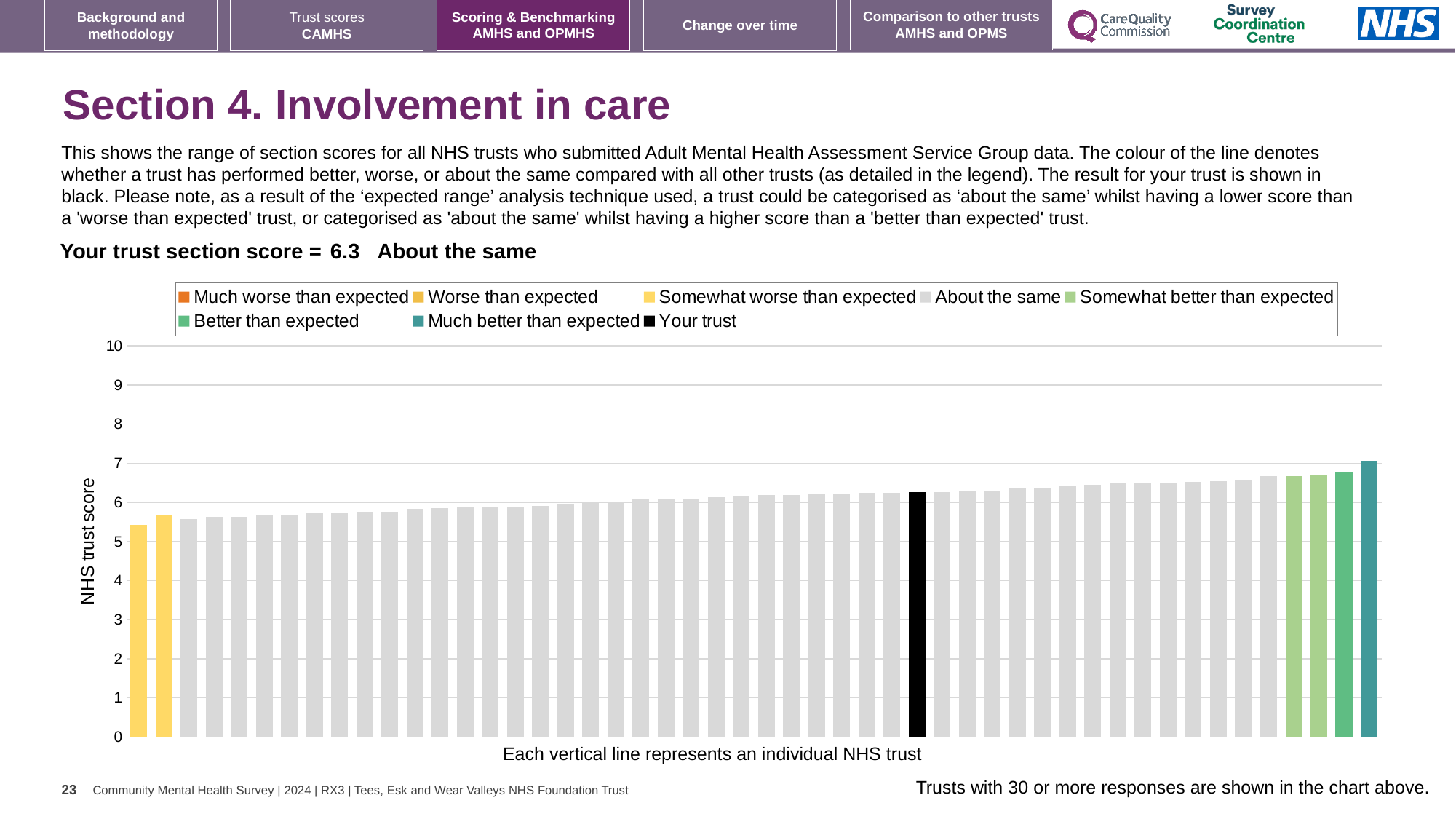
What is your trust's section score for Involvement in care? 6.3 What is the label on the y axis of the chart? NHS trust score Is the rightmost bar higher or lower than your trust's black bar? higher How many entries does the chart legend list? 8 Is the value for your trust (the black bar) greater or less than 6? greater How many bars are coloured as 'Somewhat worse than expected'? 2 Do the bar values rise or fall from left to right along the x axis? rise Which legend category does the lowest bar belong to? Somewhat worse than expected Is the value of the leftmost bar greater or less than 5? greater What kind of chart is shown on the slide? bar chart Is the value of the leftmost bar greater or less than 6? less Which legend category does the highest bar belong to? Much better than expected